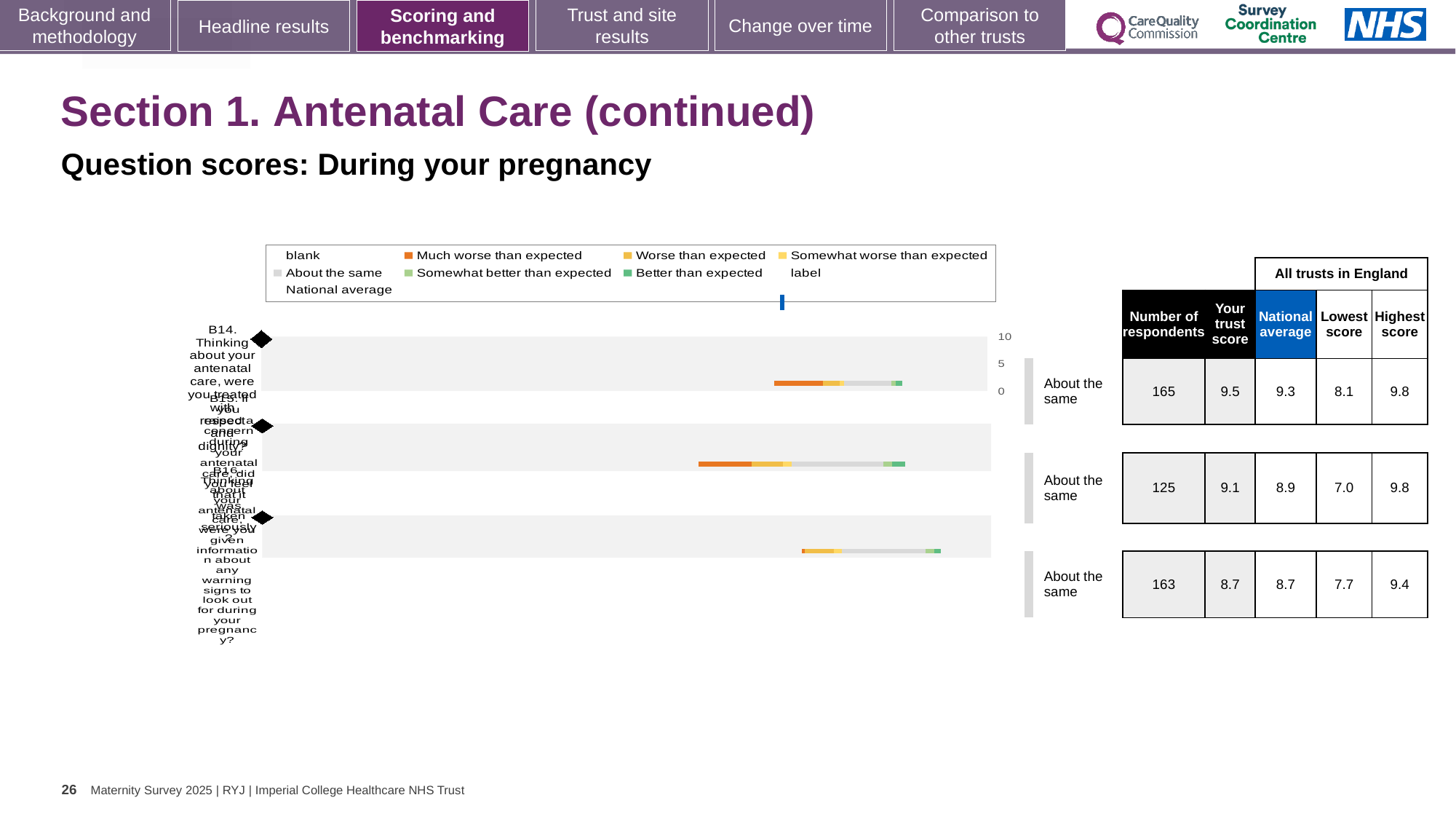
Which of the three questions has the lowest 'Lowest score' across all trusts in England? the second question (7.0) Which of the three questions has the highest 'Your trust score'? B14 (9.5) What is the highest tick value shown on the chart's numeric axis? 10 For the second question, which is larger: the trust score or the national average? the trust score (9.1) What kind of chart is shown on the slide? bar chart What is the national average for the first question (B14)? 9.3 How many respondents answered the third question (B16, information about warning signs)? 163 What is the highest score across all trusts in England for the third question (B16)? 9.4 What is the 'Your trust score' for the first question (B14, treated with respect and dignity)? 9.5 How many question bars are plotted in the chart? 3 What benchmark category is shown for each of the three questions? About the same What is the difference between the trust score and the national average for the first question (B14)? 0.2